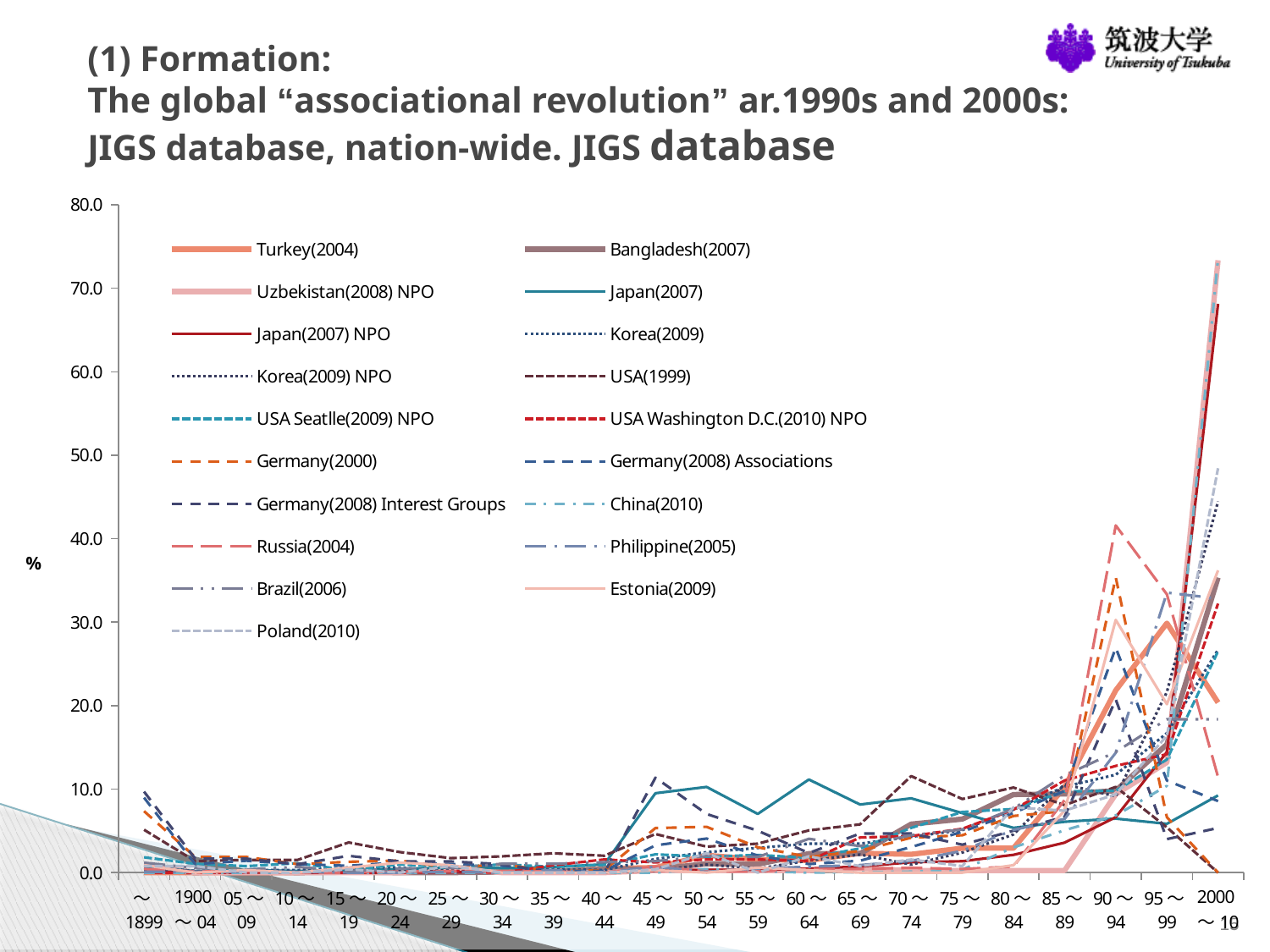
Is the value for Japan(2007) NPO in the 2000~10 period greater or less than 60? greater Do the values for Uzbekistan(2008) NPO generally rise or fall from the 85~89 period to the 2000~10 period? rise How many series does the legend list? 19 Is the value for Russia(2004) in the 90~94 period greater or less than 30? greater Is the value for USA(1999) in the 2000~10 period greater or less than 10? less What kind of chart is shown on the slide? line chart What is the highest value shown on the vertical axis? 80.0 What is the label on the vertical axis? % How many time-period categories are shown along the x axis? 22